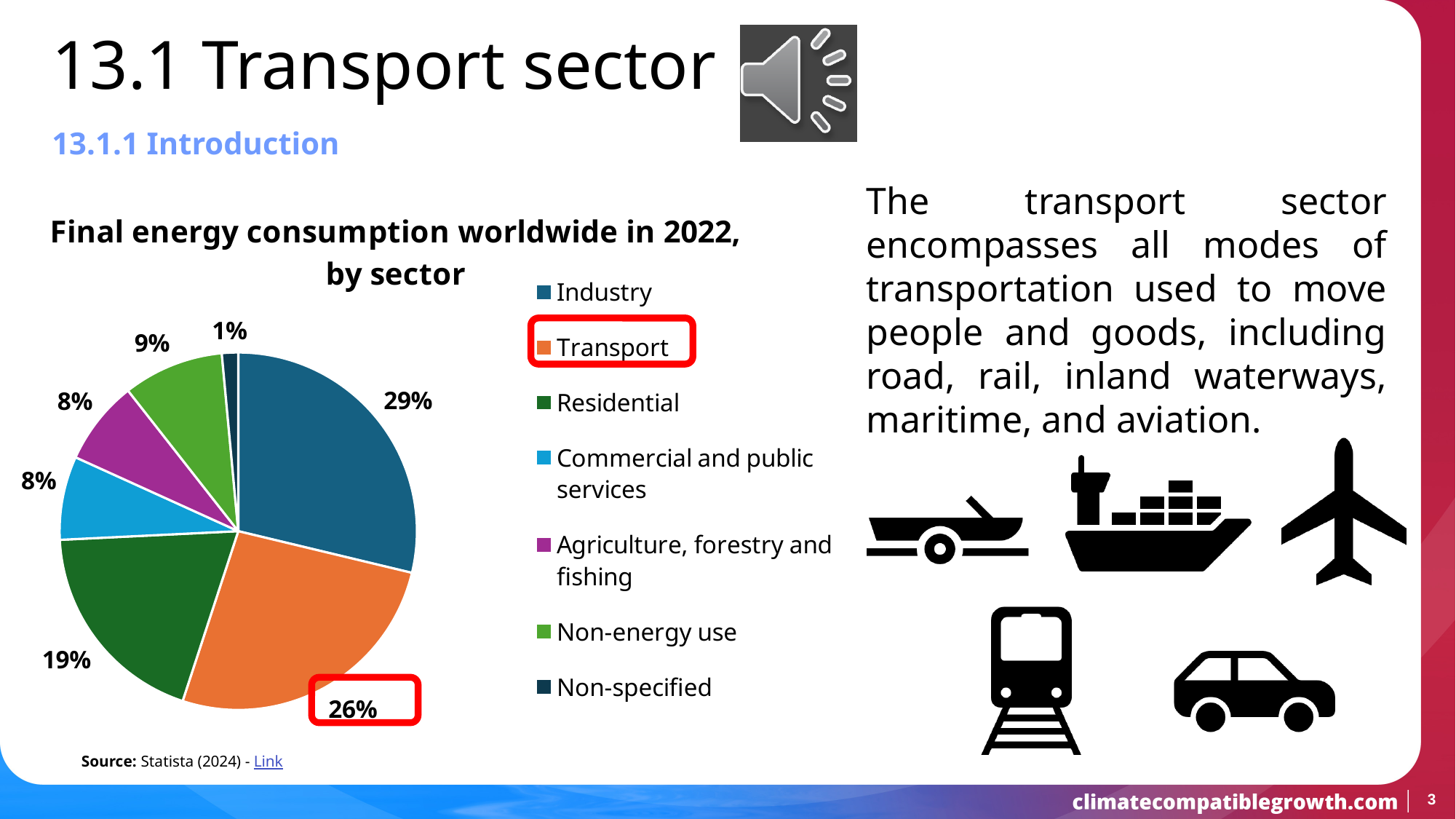
What share does Non-energy use have in the pie chart? 9% What share of final energy consumption worldwide in 2022 does the Transport sector account for? 26% What is the share for Non-specified in the pie chart? 1% Which has a larger share, Residential or Non-energy use? Residential Which sector has the largest share of final energy consumption worldwide in 2022? Industry What is the share for Residential in the pie chart? 19% What percentage of the pie chart is attributed to Industry? 29% Which sector has the smallest share in the pie chart? Non-specified What type of chart is used to show final energy consumption worldwide in 2022 by sector? Pie chart How many sectors are shown in the pie chart? 7 What is the difference in percentage points between the Industry and Transport shares? 3 Which legend entry is highlighted with a red box on the slide? Transport